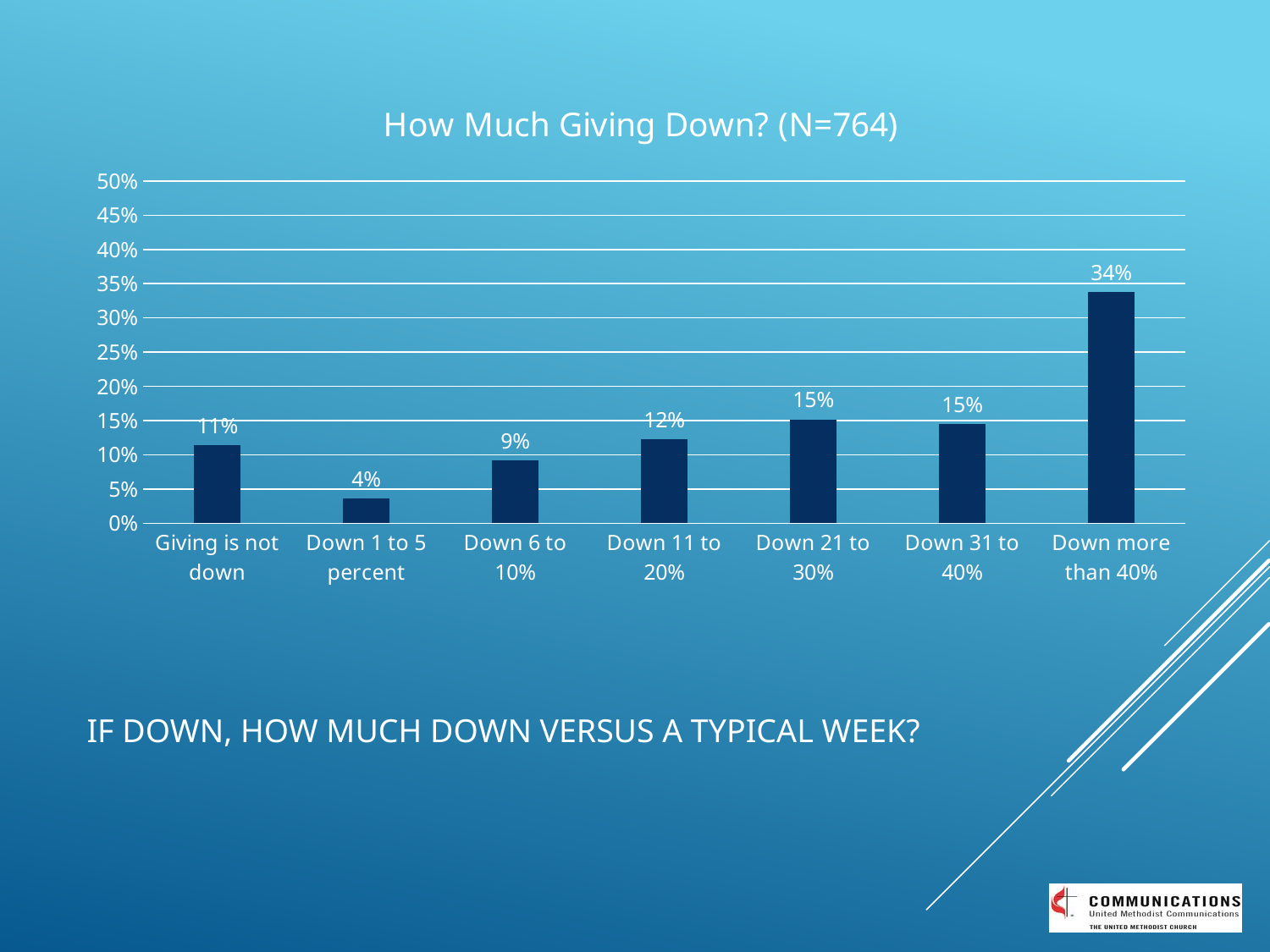
What is the value for "Down 1 to 5 percent"? 4% What is the value for "Giving is not down"? 11% What is the value for "Down more than 40%"? 34% Which category has the lowest value? Down 1 to 5 percent What is the title of the chart? How Much Giving Down? (N=764) Which category has the highest value? Down more than 40% What is the difference between the values for "Down more than 40%" and "Down 21 to 30%"? 19% How many categories are shown on the x axis? 7 What kind of chart is shown on the slide? Bar chart Which is larger, the value for "Down 11 to 20%" or the value for "Down 6 to 10%"? Down 11 to 20% What is the value for "Down 6 to 10%"? 9% What is the highest value shown on the y axis? 50%